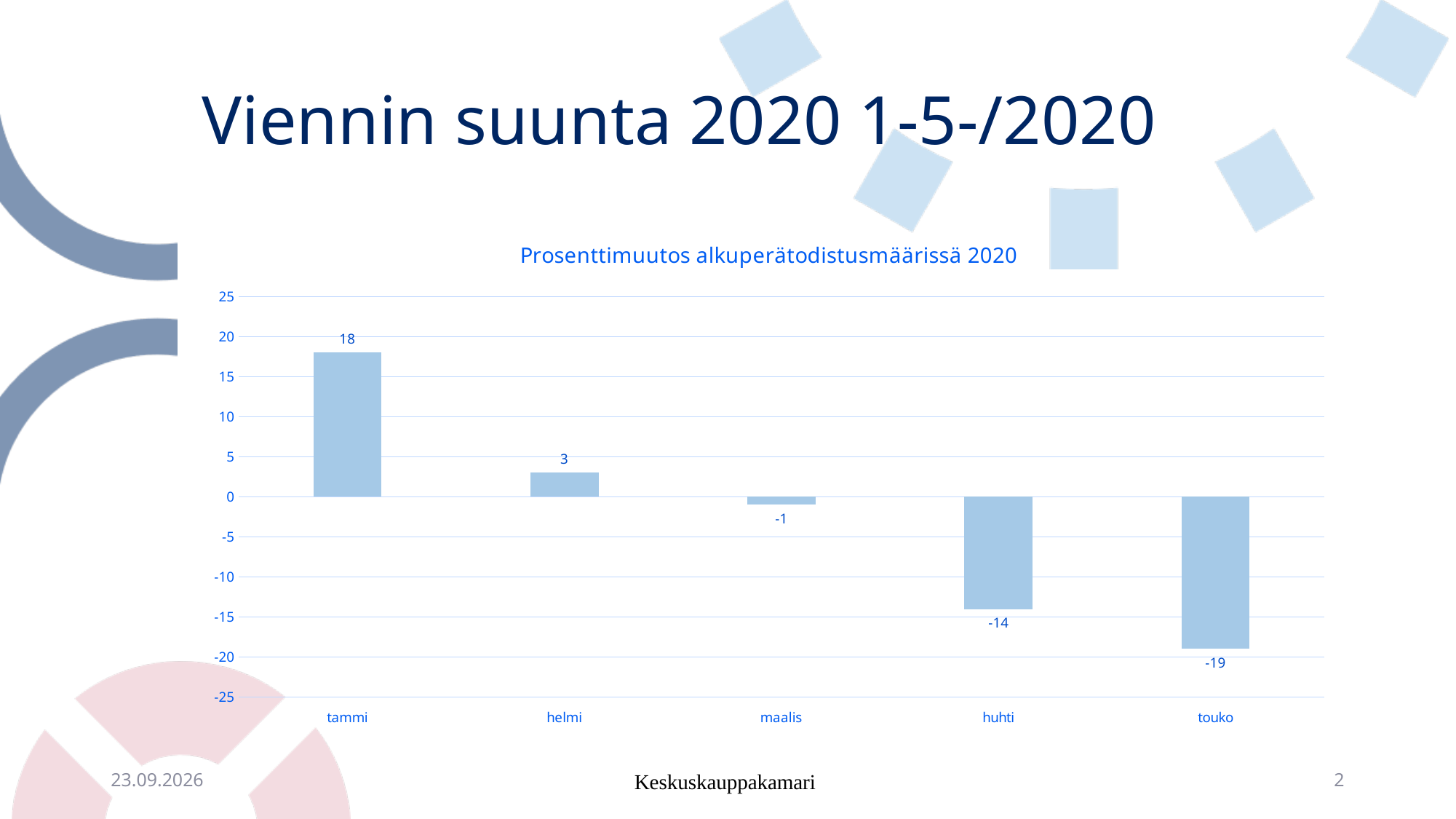
Which month has the lowest value? touko What is the value for huhti? -14 What is the value for tammi? 18 How many months are shown on the x axis? 5 Which month has the highest value? tammi What is the difference between the values for tammi and helmi? 15 What is the value for helmi? 3 What is the value for touko? -19 What is the value for maalis? -1 What kind of chart is shown on the slide? bar chart What is the title of the chart? Prosenttimuutos alkuperätodistusmäärissä 2020 Which is larger, the value for huhti or the value for touko? huhti